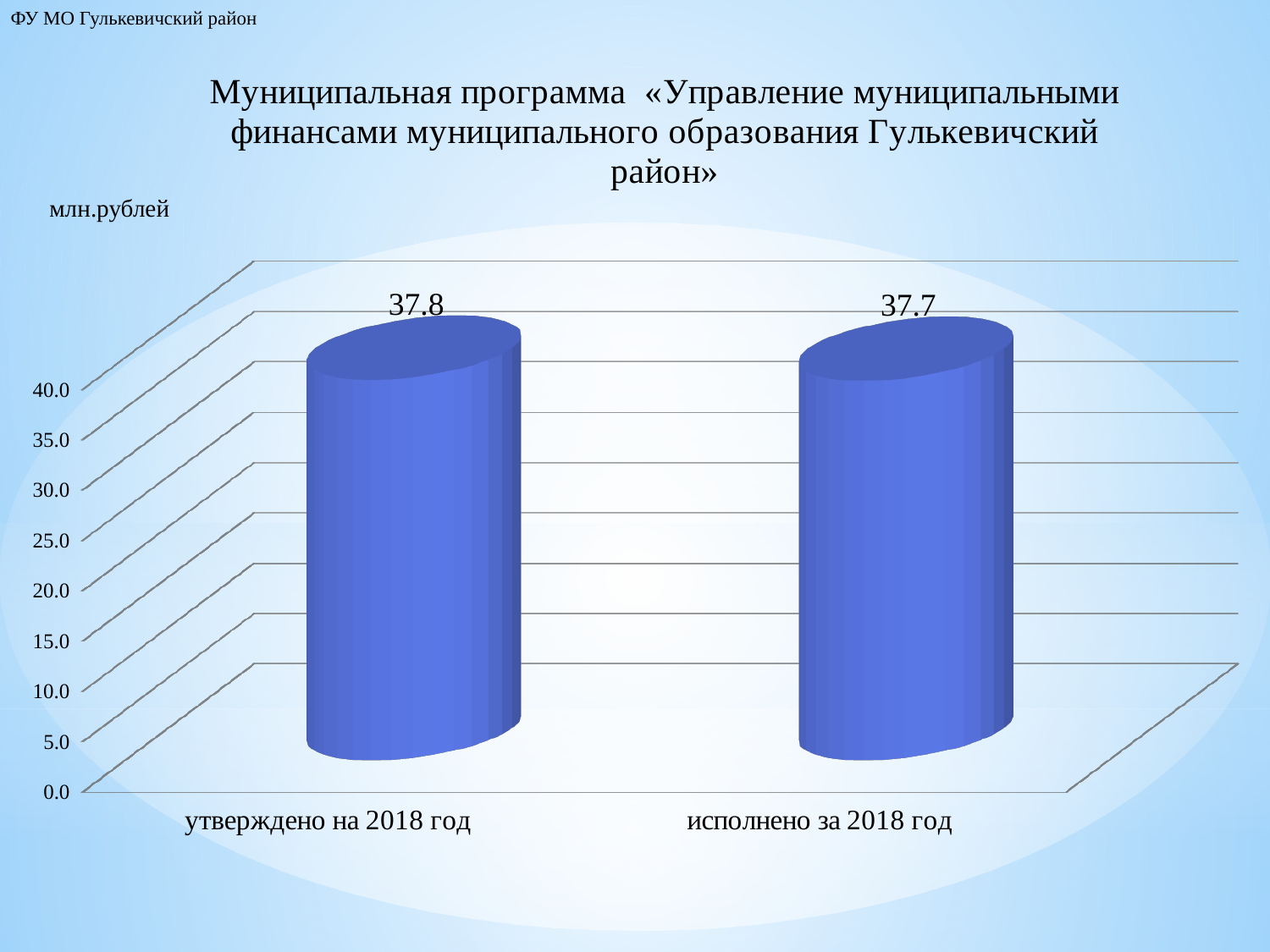
What is the highest value shown on the vertical axis? 40.0 What kind of chart is shown on the slide? bar chart Is the value for «исполнено за 2018 год» greater or less than 35.0? greater Is the value for «утверждено на 2018 год» greater or less than 40.0? less Which category has the lowest value? исполнено за 2018 год What is the difference between the value for «утверждено на 2018 год» and the value for «исполнено за 2018 год»? 0.1 What unit of measurement is indicated for the chart values? млн.рублей What is the value for «утверждено на 2018 год»? 37.8 Which category has the higher value, «утверждено на 2018 год» or «исполнено за 2018 год»? утверждено на 2018 год How many categories are shown on the chart? 2 What is the value for «исполнено за 2018 год»? 37.7